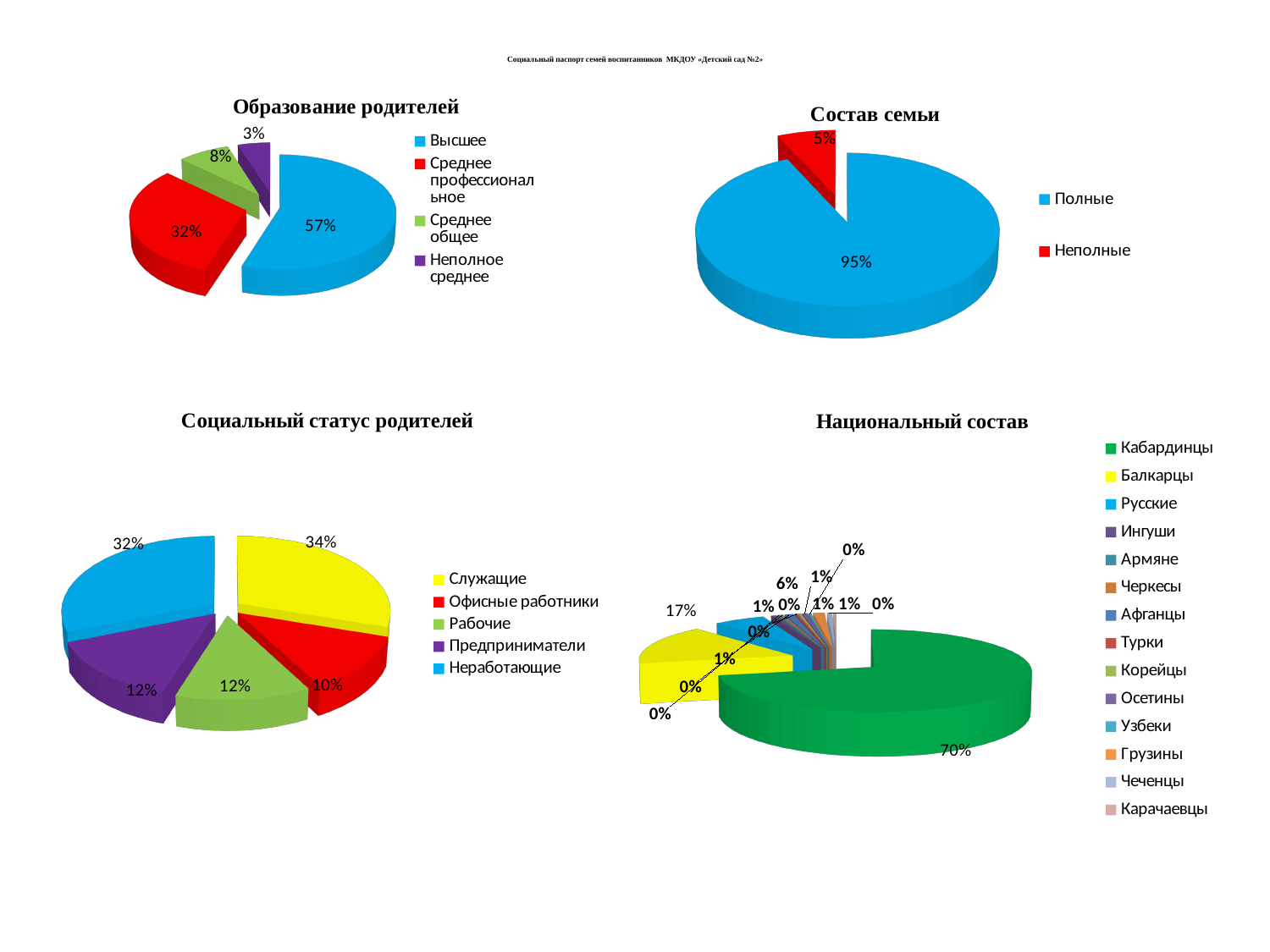
In the 'Социальный статус родителей' chart, what percentage is shown for 'Служащие'? 34% In the 'Образование родителей' chart, which category has the smallest share? Неполное среднее In the 'Социальный статус родителей' chart, how many categories does the legend list? 5 In the 'Социальный статус родителей' chart, which is larger: 'Неработающие' or 'Офисные работники'? Неработающие In the 'Состав семьи' chart, how many categories are shown? 2 In the 'Образование родителей' chart, what is the difference between the shares of 'Высшее' and 'Среднее профессиональное'? 25% In the 'Состав семьи' chart, what percentage is shown for 'Неполные'? 5% In the 'Социальный статус родителей' chart, which category has the largest share? Служащие In the 'Национальный состав' chart, how many entries does the legend list? 14 In the 'Национальный состав' chart, what percentage is shown for 'Кабардинцы'? 70% What type of chart is 'Состав семьи'? Pie chart In the 'Образование родителей' chart, what percentage is shown for 'Высшее'? 57%